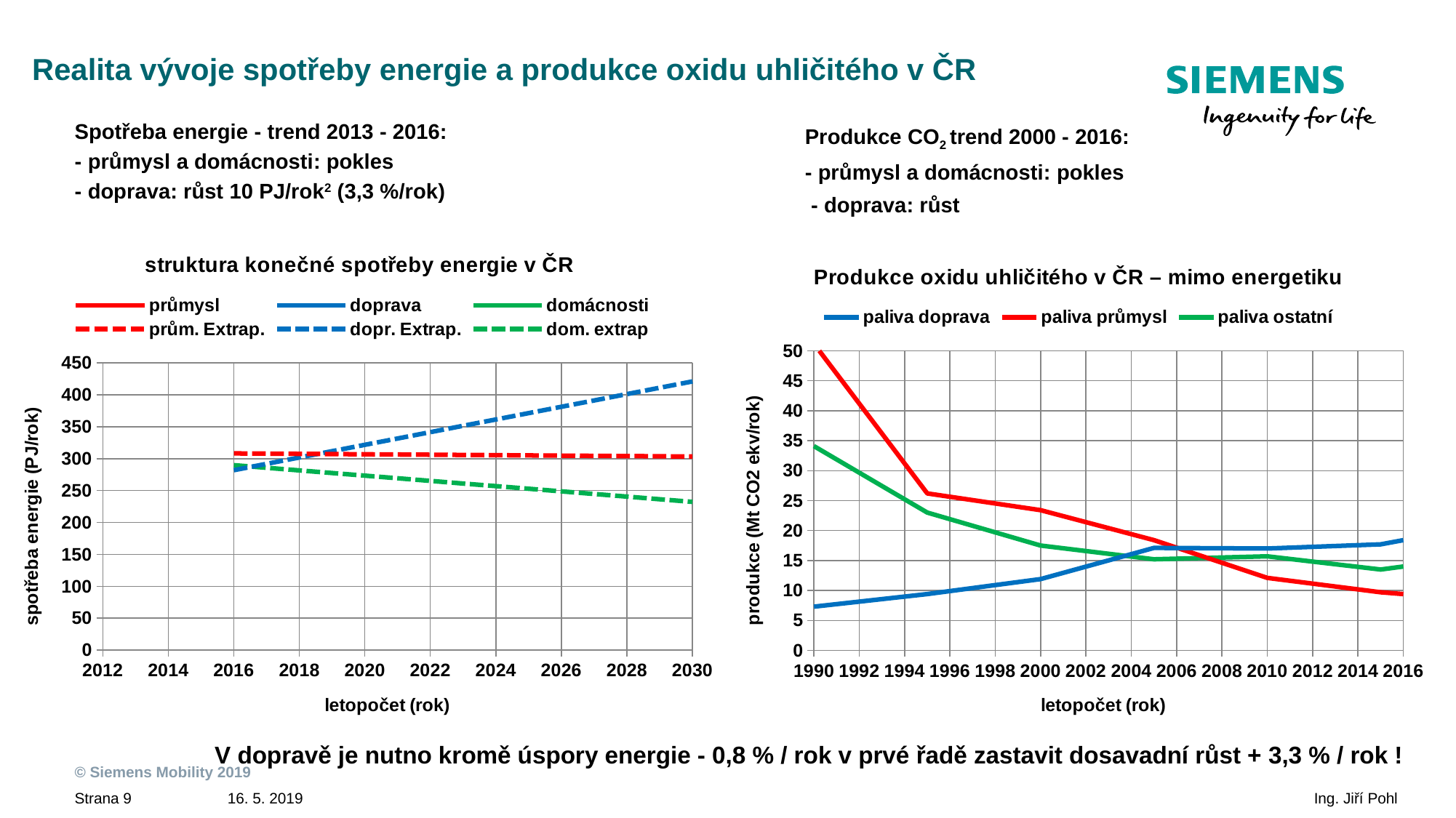
What kind of chart is the chart titled 'struktura konečné spotřeby energie v ČR'? line chart In the chart 'struktura konečné spotřeby energie v ČR', does the 'dopr. Extrap.' line rise or fall from 2016 to 2030? rise In the chart 'Produkce oxidu uhličitého v ČR – mimo energetiku', which series has the highest value in 1990? paliva průmysl In the chart 'struktura konečné spotřeby energie v ČR', is the value of 'dom. extrap' in 2030 greater or less than 250? less In the chart 'Produkce oxidu uhličitého v ČR – mimo energetiku', is the value of 'paliva doprava' in 1990 greater or less than 10? less How many series does the legend of the chart 'struktura konečné spotřeby energie v ČR' list? 6 How many series does the legend of the chart 'Produkce oxidu uhličitého v ČR – mimo energetiku' list? 3 In the chart 'struktura konečné spotřeby energie v ČR', does the 'dom. extrap' line rise or fall from 2016 to 2030? fall In the chart 'struktura konečné spotřeby energie v ČR', is the value of 'dopr. Extrap.' in 2030 greater or less than 400? greater In the chart 'Produkce oxidu uhličitého v ČR – mimo energetiku', does the 'paliva průmysl' line rise or fall from 1990 to 2016? fall In the chart 'Produkce oxidu uhličitého v ČR – mimo energetiku', which is larger in 2016: 'paliva doprava' or 'paliva průmysl'? paliva doprava What is the y-axis label of the chart 'struktura konečné spotřeby energie v ČR'? spotřeba energie (PJ/rok)